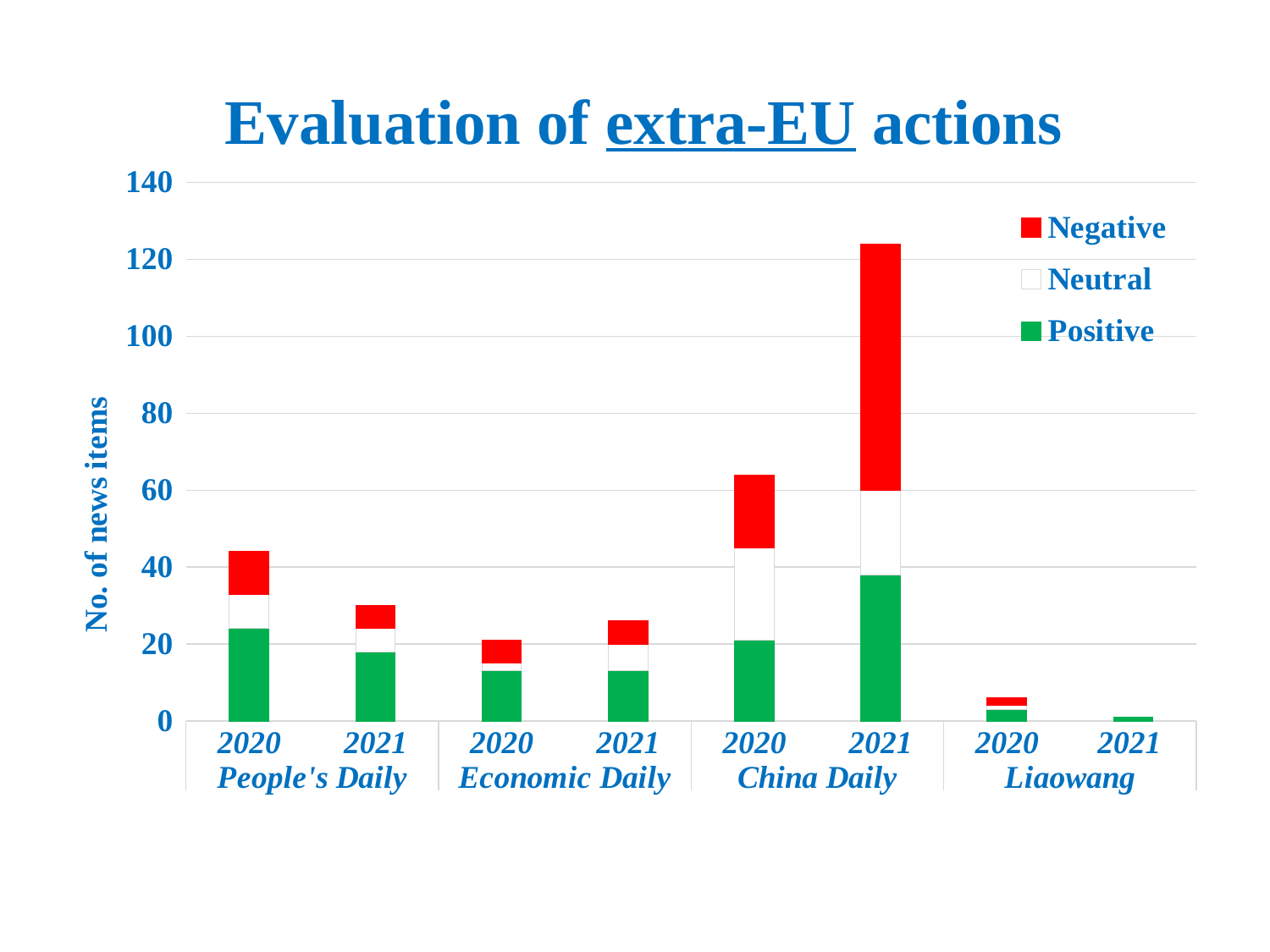
Is the total for Economic Daily 2020 greater or less than 40? less Which is larger, the total for People's Daily 2020 or People's Daily 2021? People's Daily 2020 What colour represents the Negative series in the legend? Red What kind of chart is shown on the slide? Stacked bar chart Which bar has the highest total number of news items? China Daily 2021 How many series does the legend list? 3 Is the total for Liaowang 2020 greater or less than 20? less Which bar has the lowest total number of news items? Liaowang 2021 How many bars are plotted in the chart? 8 Which is larger, the total for China Daily 2020 or China Daily 2021? China Daily 2021 Is the total for China Daily 2020 greater or less than 40? greater